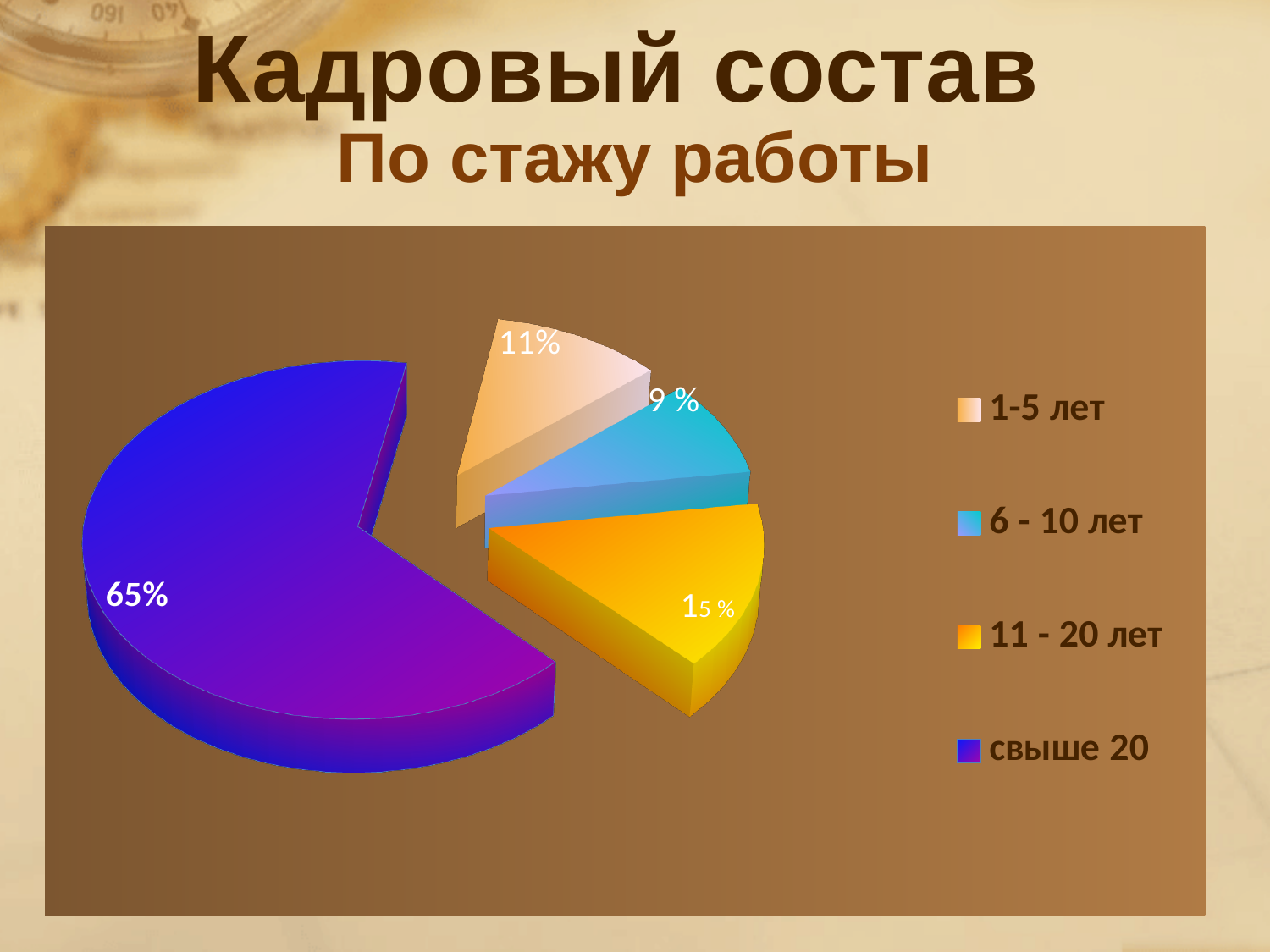
What value is shown for the "11 - 20 лет" slice? 15 % Which is larger, the slice for "1-5 лет" or the slice for "11 - 20 лет"? 11 - 20 лет What kind of chart is shown on the slide? pie chart What share of the pie is labelled for the "свыше 20" category? 65% Which category has the smallest slice of the pie? 6 - 10 лет What is the difference in percentage points between the "1-5 лет" slice and the "6 - 10 лет" slice? 2 Which category has the largest slice of the pie? свыше 20 How many categories does the pie chart show? 4 What value is shown for the "1-5 лет" slice? 11% What value is shown for the "6 - 10 лет" slice? 9 % What colour is the slice for "11 - 20 лет"? yellow/orange What is the difference in percentage points between the "свыше 20" slice and the "11 - 20 лет" slice? 50